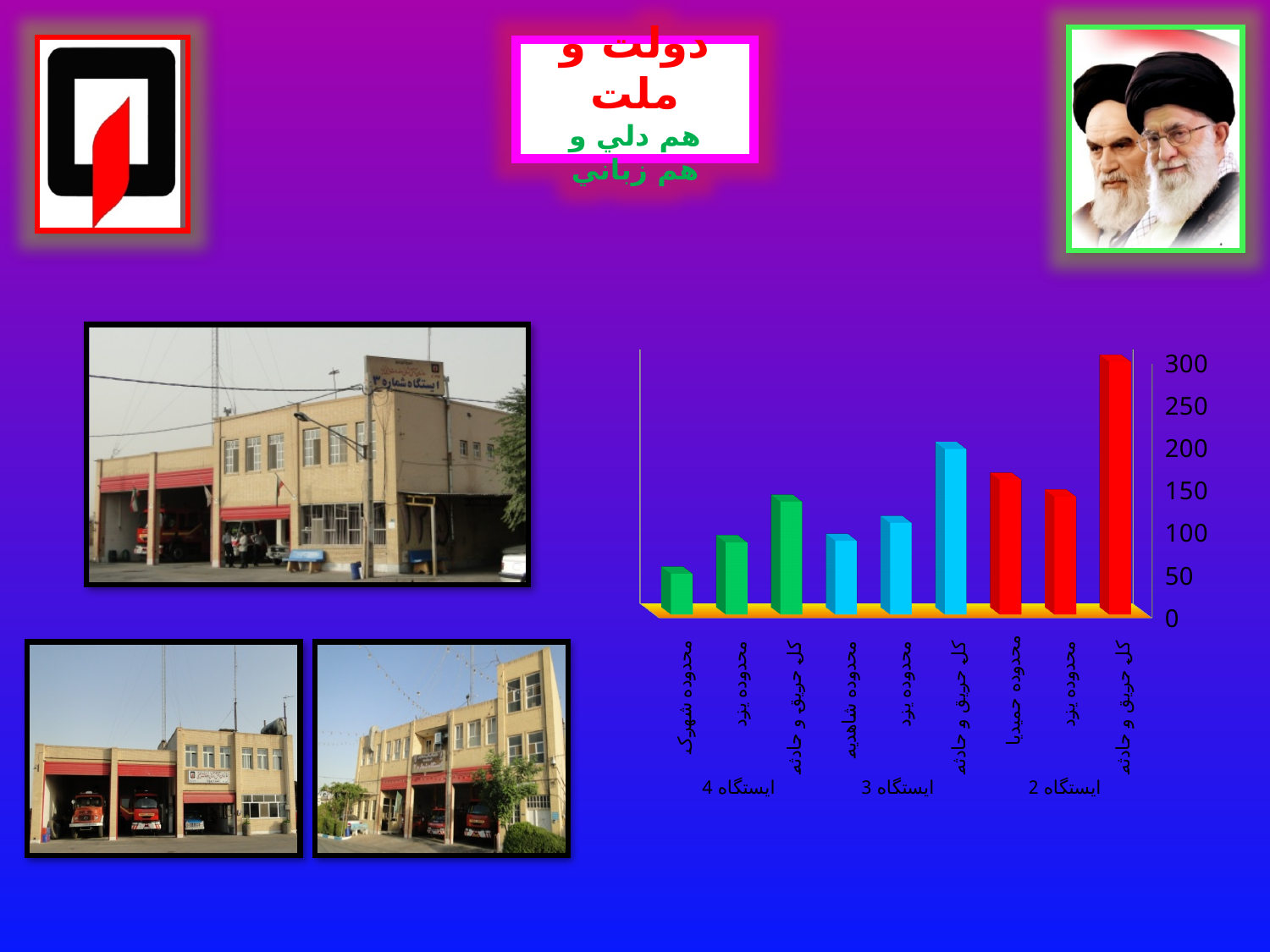
Is the value for محدوده شاهدیه in ایستگاه 3 greater or less than 150? less Which bar in the chart is the highest? کل حریق و حادثه (ایستگاه 2) Is the value for کل حریق و حادثه in ایستگاه 2 greater or less than 250? greater Which bar in the chart is the lowest? محدوده شهرک (ایستگاه 4) What kind of chart is shown on the slide? bar chart How many station groups (ایستگاه) are shown along the x axis of the chart? 3 Is the value for کل حریق و حادثه in ایستگاه 3 greater or less than 150? greater What is the highest value shown on the chart's vertical axis? 300 What colour are the bars for ایستگاه 2 in the chart? red How many bars are plotted in the chart? 9 Which is larger: کل حریق و حادثه for ایستگاه 2 or کل حریق و حادثه for ایستگاه 3? ایستگاه 2